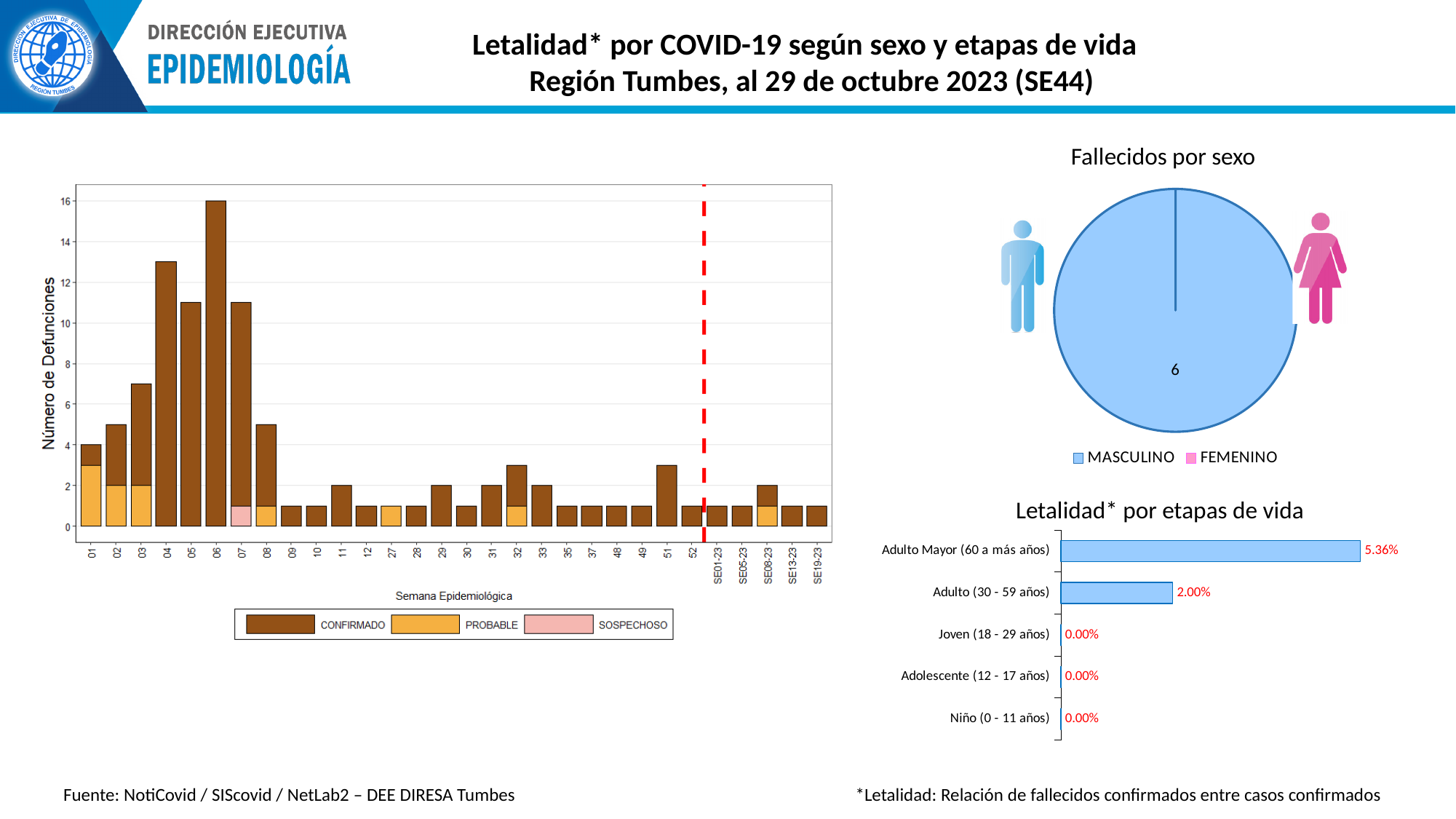
In the 'Fallecidos por sexo' pie chart, what value is shown for MASCULINO? 6 In the left chart of deaths by epidemiological week, is the value for week 04 greater or less than 12? greater In the 'Letalidad* por etapas de vida' chart, which age group has the highest lethality? Adulto Mayor (60 a más años) How many series does the legend of the 'Fallecidos por sexo' pie chart list? 2 In the 'Letalidad* por etapas de vida' chart, what is the value for Adulto Mayor (60 a más años)? 5.36% In the left chart of deaths by epidemiological week, how many deaths are shown for week 06? 16 In the 'Letalidad* por etapas de vida' chart, what is the value for Joven (18 - 29 años)? 0.00% How many series does the legend of the left chart of deaths by epidemiological week list? 3 In the 'Letalidad* por etapas de vida' chart, how many age groups are shown? 5 In the 'Letalidad* por etapas de vida' chart, what is the value for Adulto (30 - 59 años)? 2.00% In the 'Letalidad* por etapas de vida' chart, what is the difference between the values for Adulto Mayor (60 a más años) and Adulto (30 - 59 años)? 3.36% In the left chart of deaths by epidemiological week, which week has the highest number of deaths? 06